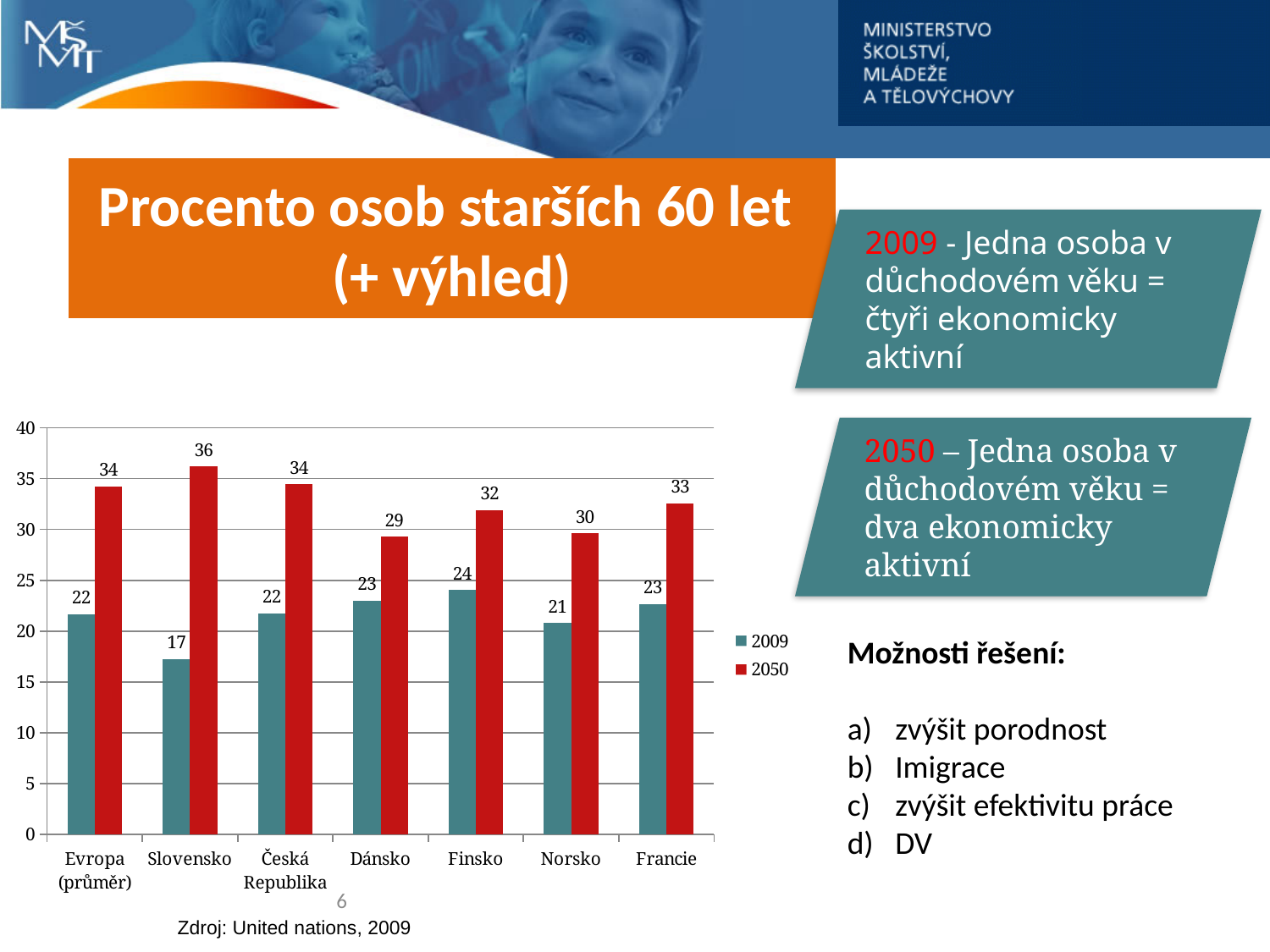
Is the 2050 value for Francie greater or less than 30? greater How many categories are shown on the x axis? 7 What is the 2050 value for Slovensko? 36 Which is larger, the 2050 value for Dánsko or the 2050 value for Norsko? Norsko Which category has the highest 2050 value? Slovensko How many series does the legend list? 2 What is the 2009 value for Norsko? 21 What are the two series named in the legend? 2009 and 2050 What is the difference between the 2050 and 2009 values for Slovensko? 19 Which category has the lowest 2009 value? Slovensko What kind of chart is shown on the slide? bar chart What is the 2009 value for Finsko? 24